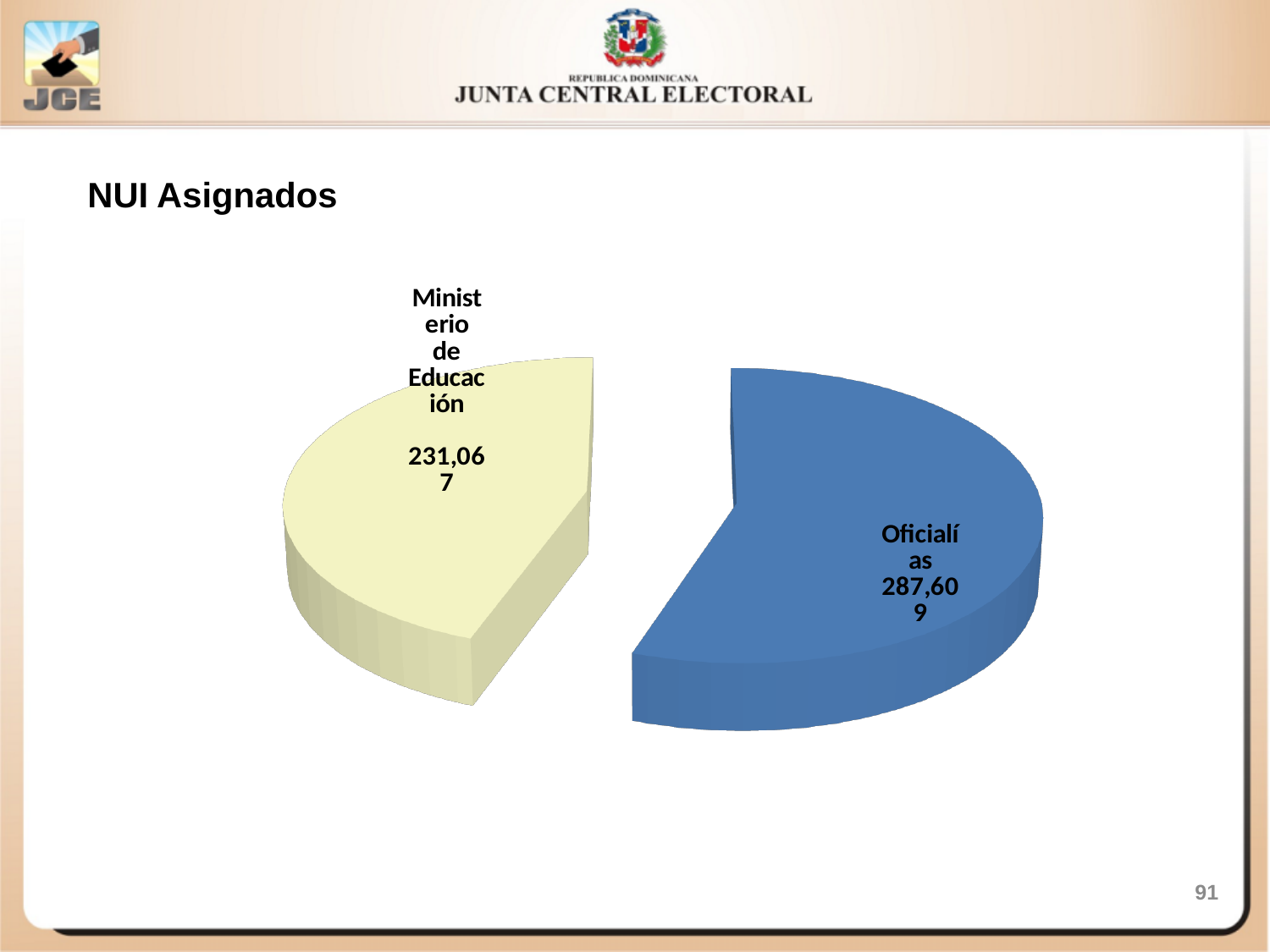
What is the total of the two slices in the pie chart? 518,676 Which category has the largest slice of the pie? Oficialías Which category has the smallest slice of the pie? Ministerio de Educación What is the difference between the value for Oficialías and the value for Ministerio de Educación? 56,542 How many slices does the pie chart have? 2 What share of the pie does Oficialías represent, to the nearest whole percent? 55% What is the value for Oficialías? 287,609 What kind of chart is shown on the slide? Pie chart What colour is the Oficialías slice? Blue What is the title of the chart? NUI Asignados What is the value for Ministerio de Educación? 231,067 Which is larger, the value for Oficialías or the value for Ministerio de Educación? Oficialías